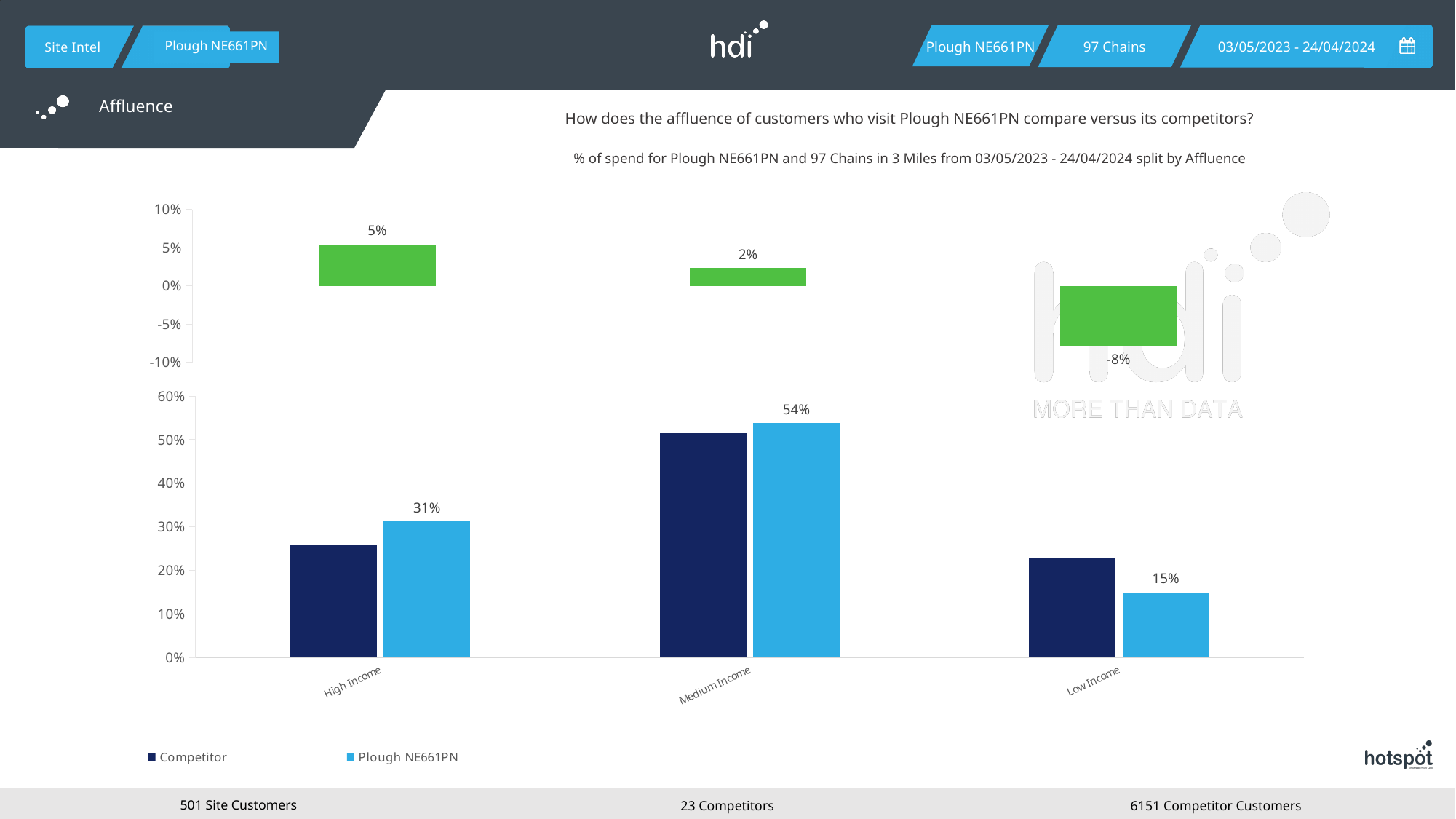
In the bottom bar chart, is the Competitor value for Low Income greater or less than 20%? greater In the top chart of green bars, what is the value shown for the High Income category? 5% In the bottom bar chart, which category has the lowest value for Plough NE661PN? Low Income In the top chart of green bars, what is the value shown for the Low Income category? -8% In the bottom bar chart, what is the value for Plough NE661PN in the Medium Income category? 54% In the bottom bar chart, what is the value for Plough NE661PN in the High Income category? 31% In the bottom bar chart, which category has the highest value for Plough NE661PN? Medium Income What type of chart is the bottom chart on the slide? Bar chart In the bottom bar chart, what is the difference between the Plough NE661PN values for Medium Income and High Income? 23% In the bottom bar chart, what is the value for Plough NE661PN in the Low Income category? 15% How many series does the legend of the bottom bar chart list? 2 In the bottom bar chart, which is larger for Low Income: the Competitor value or the Plough NE661PN value? Competitor